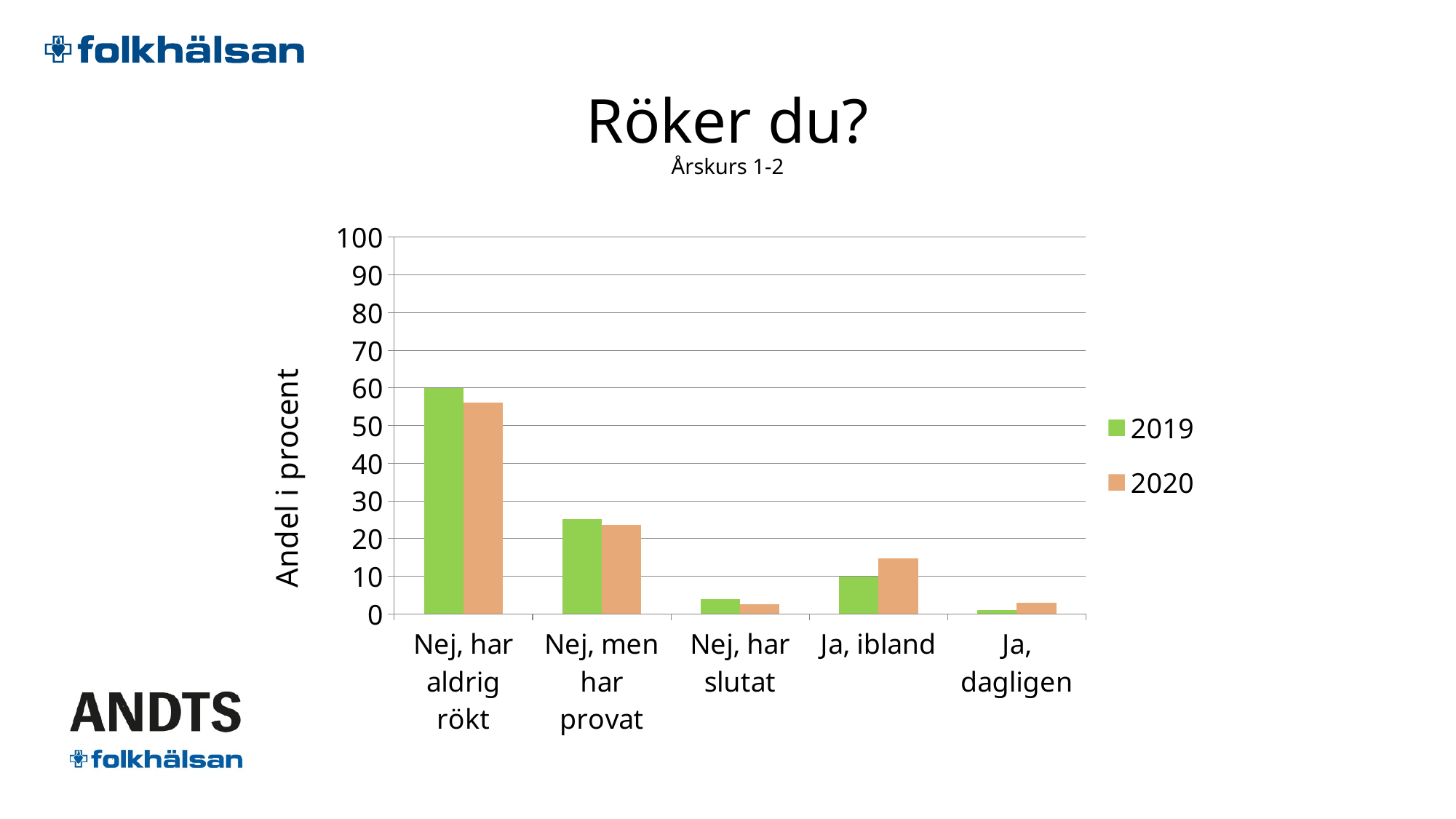
For 'Nej, har aldrig rökt', which year has the larger value, 2019 or 2020? 2019 Is the 2020 value for 'Ja, ibland' greater or less than 10? greater Is the 2020 value for 'Nej, men har provat' greater or less than 30? less How many series does the legend list? 2 What is the title of the y axis? Andel i procent Is the 2020 value for 'Nej, har aldrig rökt' greater or less than 50? greater Which category has the highest value for 2019? Nej, har aldrig rökt How many answer categories are shown on the x axis? 5 Which category has the lowest value for 2019? Ja, dagligen For 'Ja, ibland', which year has the larger value, 2019 or 2020? 2020 What kind of chart is shown on the slide? bar chart